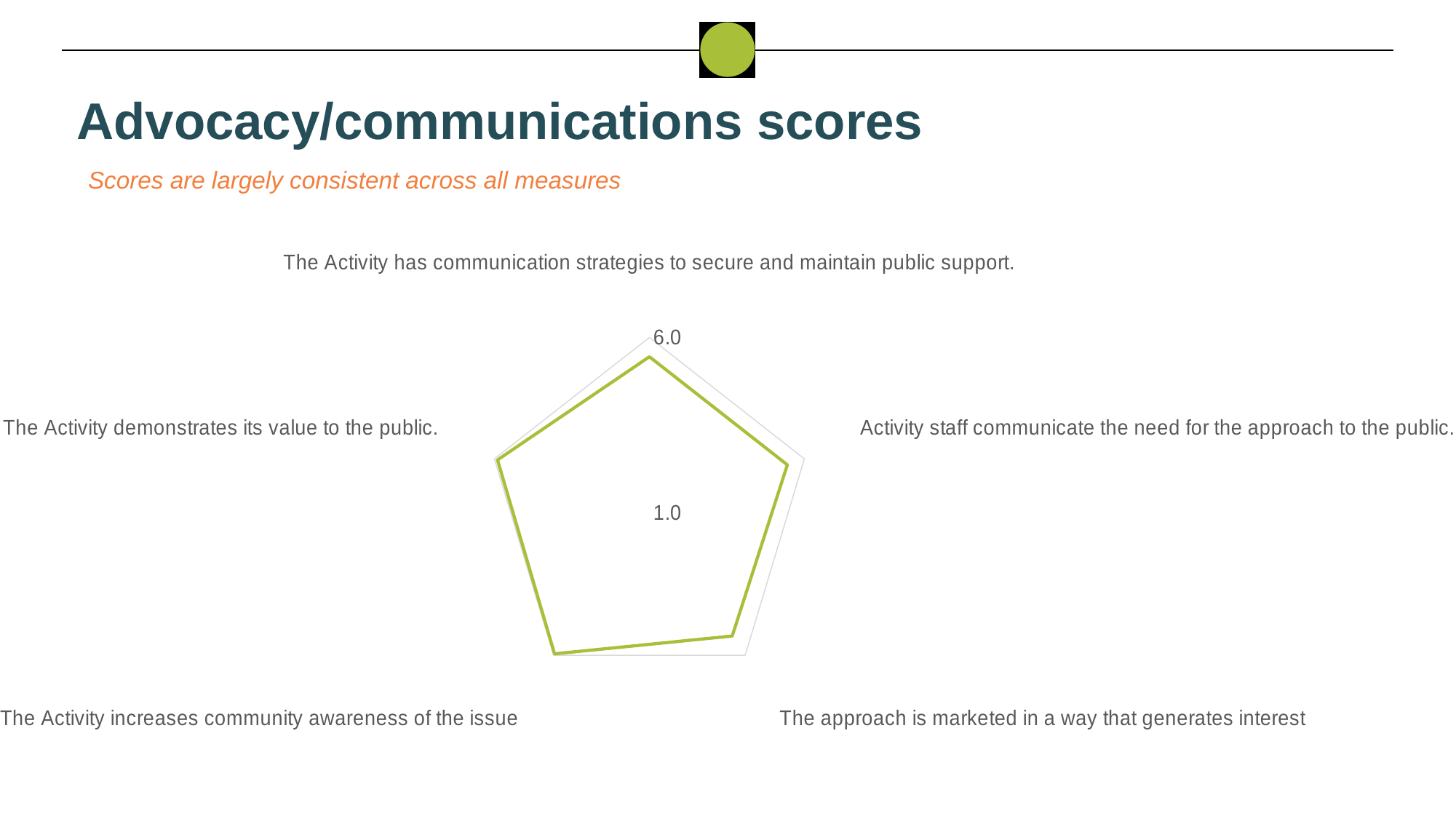
Is the value for 'The approach is marketed in a way that generates interest' greater or less than 6.0? less Which category has the lowest score on the radar chart? The approach is marketed in a way that generates interest What kind of chart is shown on the slide? Radar chart Is the value for 'Activity staff communicate the need for the approach to the public.' greater or less than 1.0? greater Is the value for 'The Activity increases community awareness of the issue' greater or less than 1.0? greater What is the title of the slide containing the radar chart? Advocacy/communications scores Which is larger: the value for 'The Activity increases community awareness of the issue' or the value for 'The approach is marketed in a way that generates interest'? The Activity increases community awareness of the issue What is the highest axis value labelled on the radar chart? 6.0 How many categories (measures) are plotted on the radar chart? 5